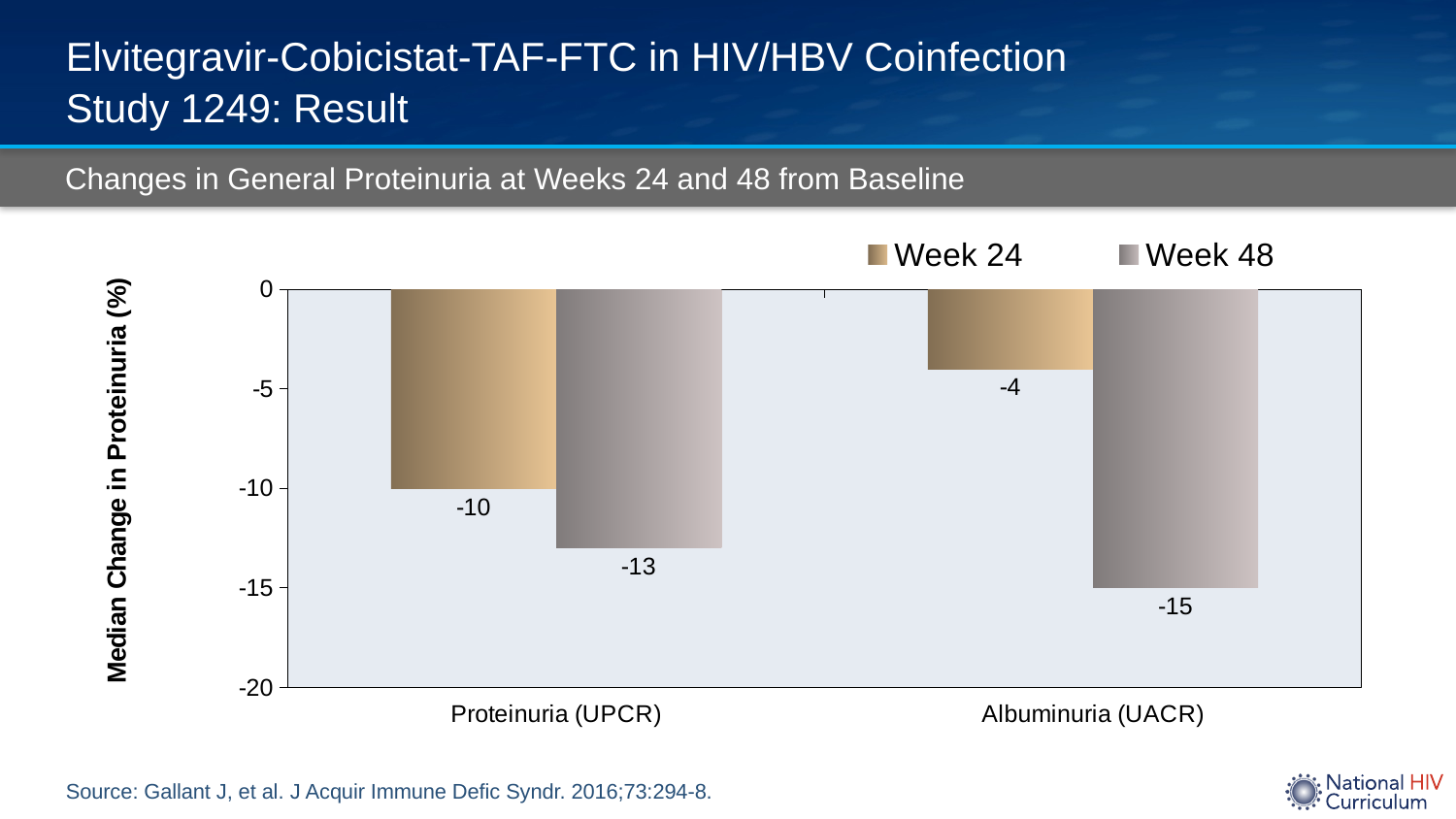
What kind of chart is shown on the slide? bar chart How many categories are shown on the x axis? 2 What is the Week 48 value for Proteinuria (UPCR)? -13 Which category has the highest Week 24 value? Albuminuria (UACR) What is the Week 48 value for Albuminuria (UACR)? -15 Is the Week 24 value for Proteinuria (UPCR) larger or smaller than the Week 24 value for Albuminuria (UACR)? smaller How many series does the legend list? 2 What is the Week 24 value for Albuminuria (UACR)? -4 What is the Week 24 value for Proteinuria (UPCR)? -10 Which category has the lowest Week 48 value? Albuminuria (UACR) What is the difference between the Week 24 and Week 48 values for Albuminuria (UACR)? 11 What is the difference between the Week 24 and Week 48 values for Proteinuria (UPCR)? 3